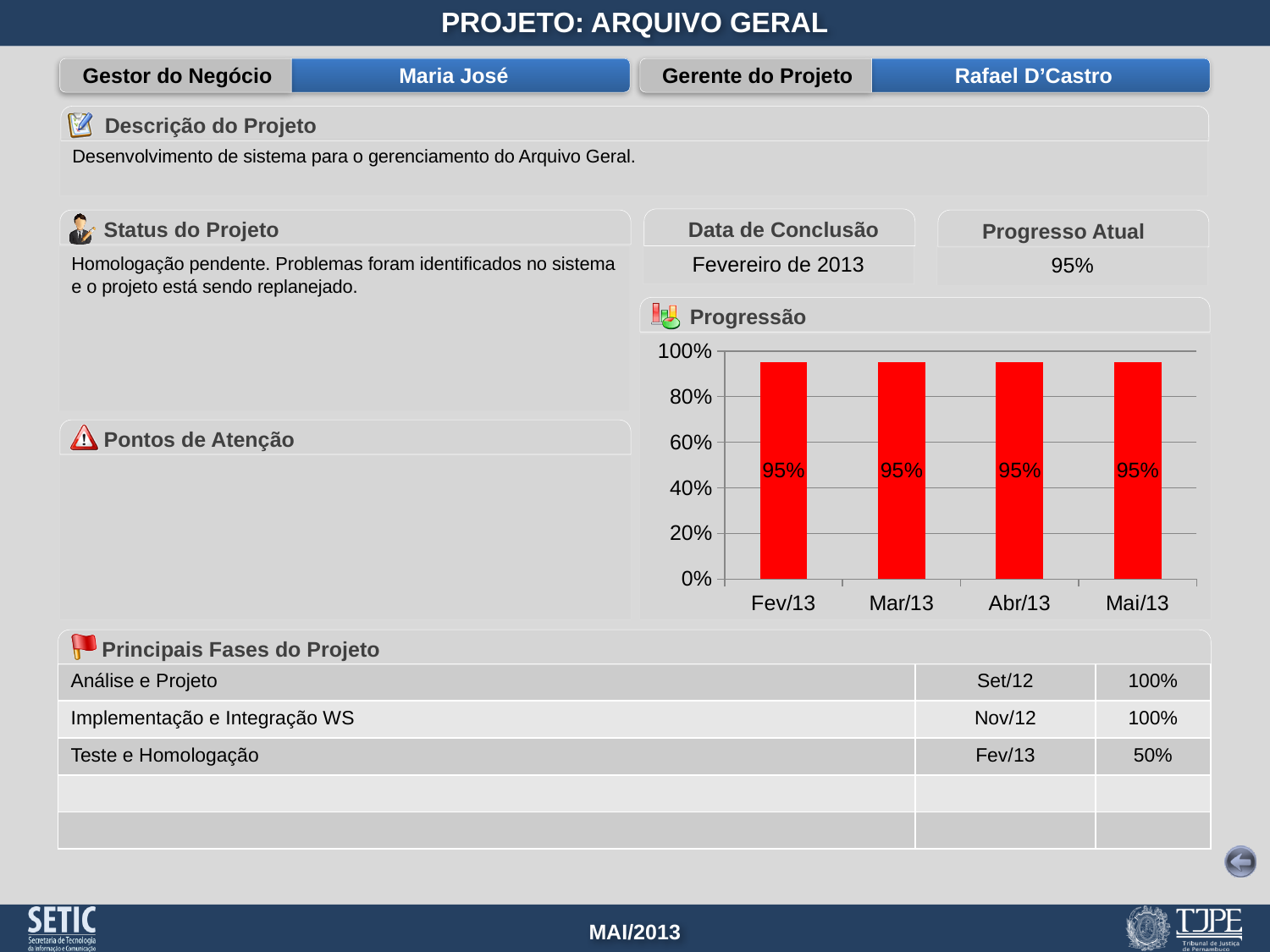
Is the value for Abr/13 in the Progressão chart greater or less than 80%? greater What colour are the bars in the Progressão chart? red Do the values in the Progressão chart rise, fall or stay flat from Fev/13 to Mai/13? stay flat What is the value for Fev/13 in the Progressão chart? 95% What is the highest tick value shown on the y axis of the Progressão chart? 100% What is the value for Mar/13 in the Progressão chart? 95% What is the title of the chart on the slide? Progressão What is the difference between the values for Fev/13 and Mai/13 in the Progressão chart? 0% What is the value for Mai/13 in the Progressão chart? 95% What kind of chart is the Progressão chart? bar chart What is the value for Abr/13 in the Progressão chart? 95% How many categories are shown on the x axis of the Progressão chart? 4